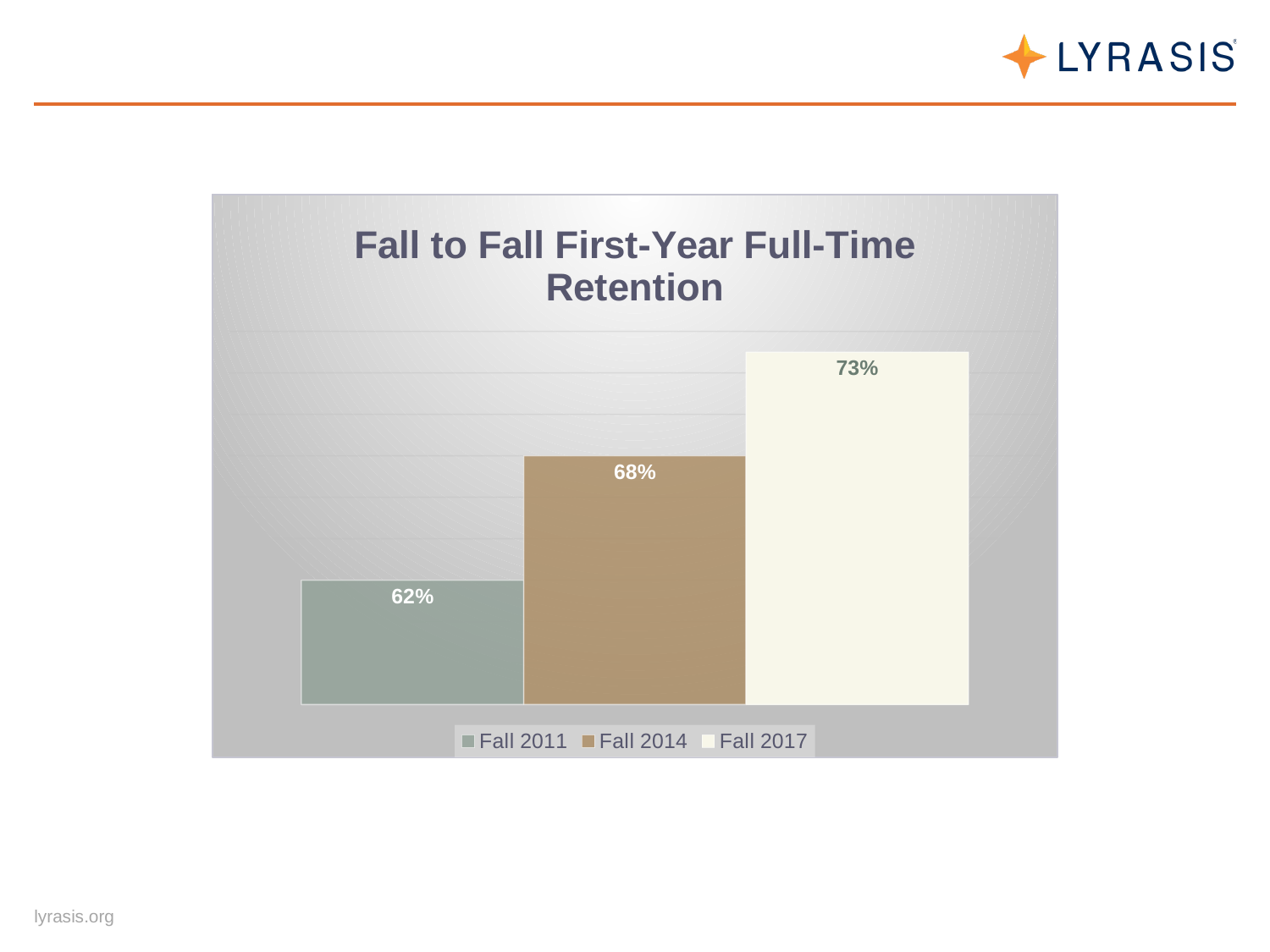
What is the difference between the Fall 2017 and Fall 2011 retention values? 11% What is the difference between the Fall 2014 and Fall 2011 retention values? 6% What is the retention value for Fall 2014? 68% What is the retention value for Fall 2017? 73% Which series has the highest retention value? Fall 2017 Do the retention values rise or fall from Fall 2011 to Fall 2017? Rise How many series does the legend list? 3 What kind of chart is shown on the slide? Bar chart Which series has the lowest retention value? Fall 2011 What is the retention value for Fall 2011? 62% What is the title of the chart? Fall to Fall First-Year Full-Time Retention Which is larger, the value for Fall 2014 or the value for Fall 2017? Fall 2017